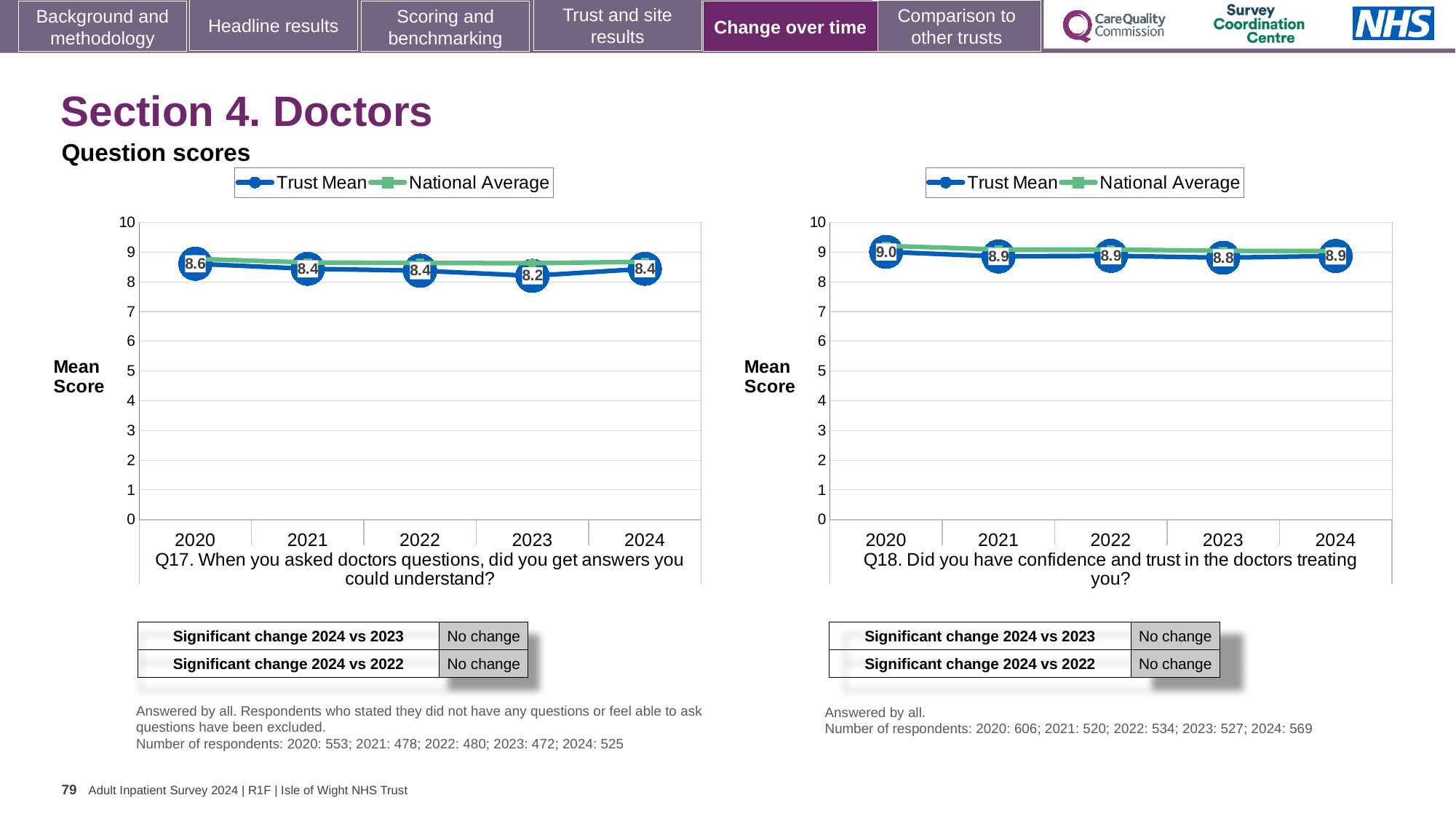
In the Q17 chart on the left, what is the Trust Mean score for 2020? 8.6 What type of chart is the Q18 chart on the right? Line chart In the Q18 chart on the right, which year has the highest Trust Mean score? 2020 How many years are plotted on the x axis of the Q18 chart on the right? 5 In the Q18 chart on the right, is the Trust Mean score for 2020 larger or smaller than the score for 2023? larger In the Q17 chart on the left, is the National Average value for 2023 greater or less than 8? greater In the Q18 chart on the right, what is the Trust Mean score for 2024? 8.9 How many series does the legend of the Q17 chart on the left list? 2 In the Q17 chart on the left, does the Trust Mean score rise or fall from 2020 to 2023? fall In the Q17 chart on the left, which year has the lowest Trust Mean score? 2023 In the Q17 chart on the left, what is the Trust Mean score for 2023? 8.2 In the Q17 chart on the left, what is the difference between the Trust Mean scores for 2020 and 2023? 0.4